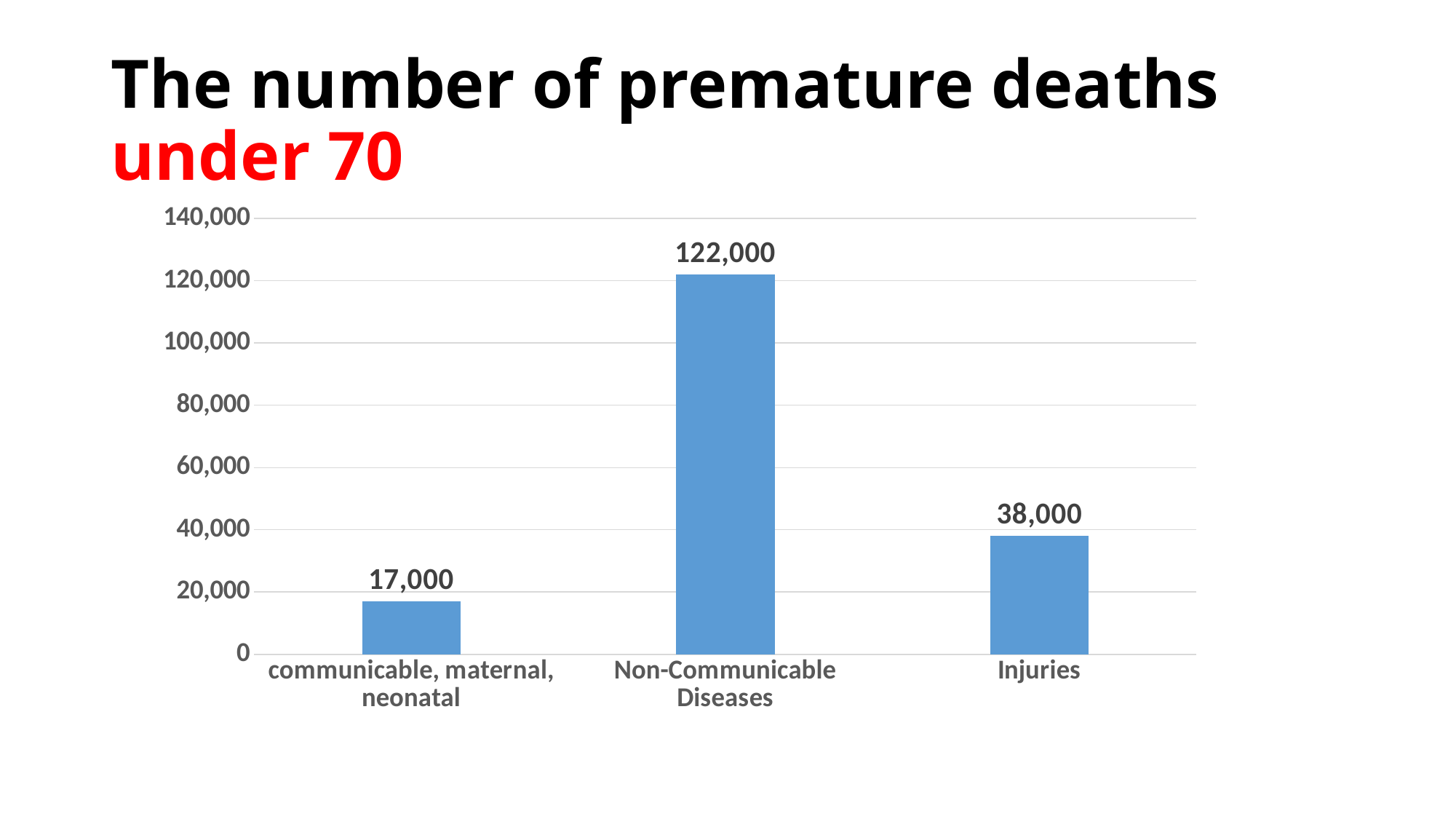
What is the difference between the number of premature deaths for Non-Communicable Diseases and Injuries? 84,000 Which is larger: the number of premature deaths for Injuries or for communicable, maternal, neonatal causes? Injuries What is the number of premature deaths for Injuries? 38,000 What kind of chart is shown on the slide? bar chart What is the difference between the number of premature deaths for Injuries and communicable, maternal, neonatal causes? 21,000 How many categories are shown in the chart? 3 Which category has the highest number of premature deaths? Non-Communicable Diseases What is the number of premature deaths for Non-Communicable Diseases? 122,000 Which category has the lowest number of premature deaths? communicable, maternal, neonatal What is the title of the slide? The number of premature deaths under 70 Is the value for Non-Communicable Diseases greater or less than 100,000? greater What is the number of premature deaths for communicable, maternal, neonatal causes? 17,000